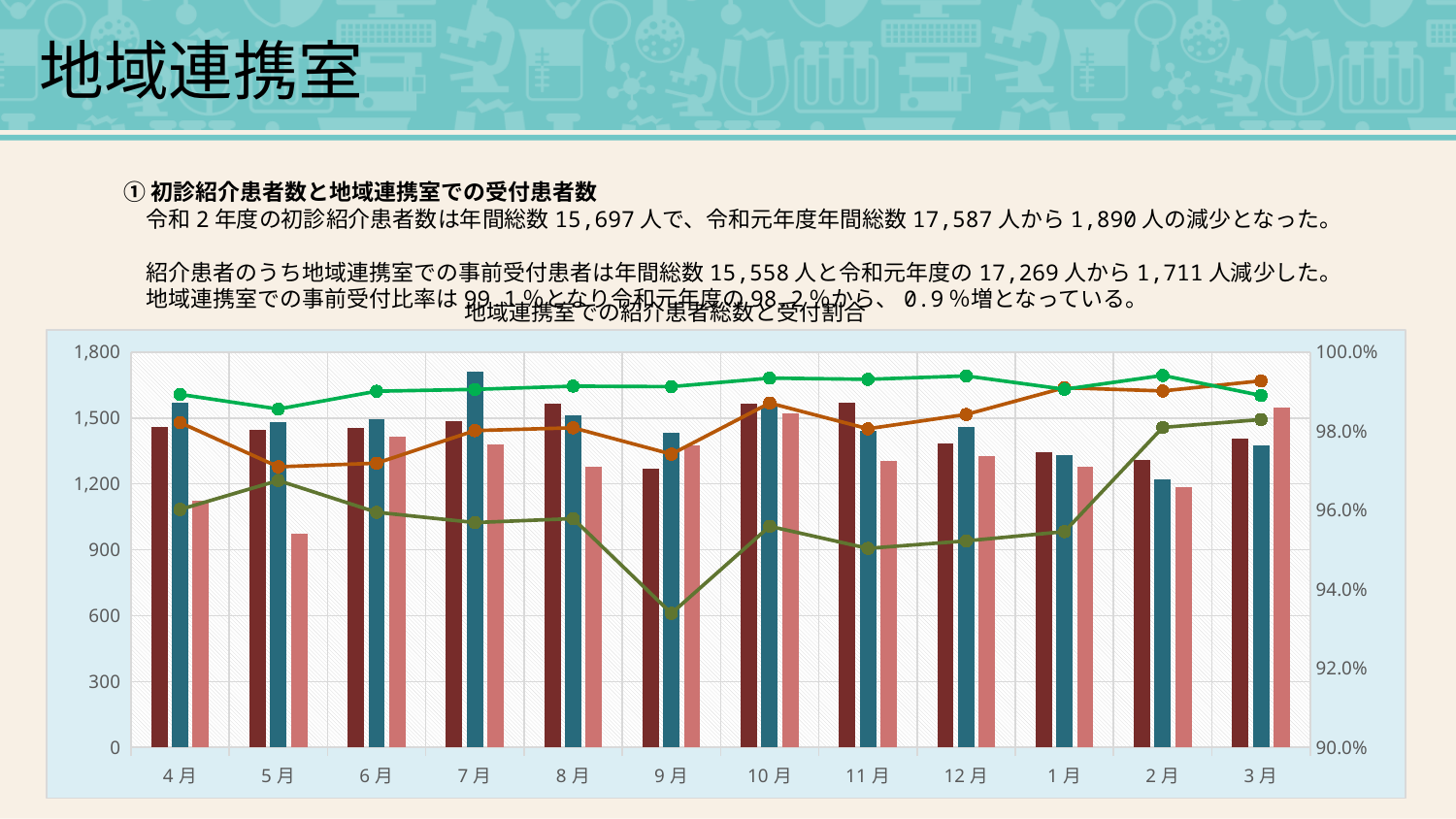
Is the teal bar for 7月 greater or less than 1,500? greater Is the olive-green line value for 9月 greater or less than 94.0%? less In which month is the teal (middle) bar the tallest? 7月 Which is larger, the dark red bar for 4月 or the dark red bar for 9月? 4月 How many months are shown along the x axis of the chart? 12 Does the olive-green line rise or fall from 12月 to 3月? rise Is the pink bar for 5月 greater or less than 1,200? less What is the title of the chart? 地域連携室での紹介患者総数と受付割合 What kind of chart is shown on the slide? A combined bar and line chart In which month does the olive-green line reach its lowest point? 9月 How many bars are plotted for each month in the chart? 3 In which month is the pink (right) bar the shortest? 5月